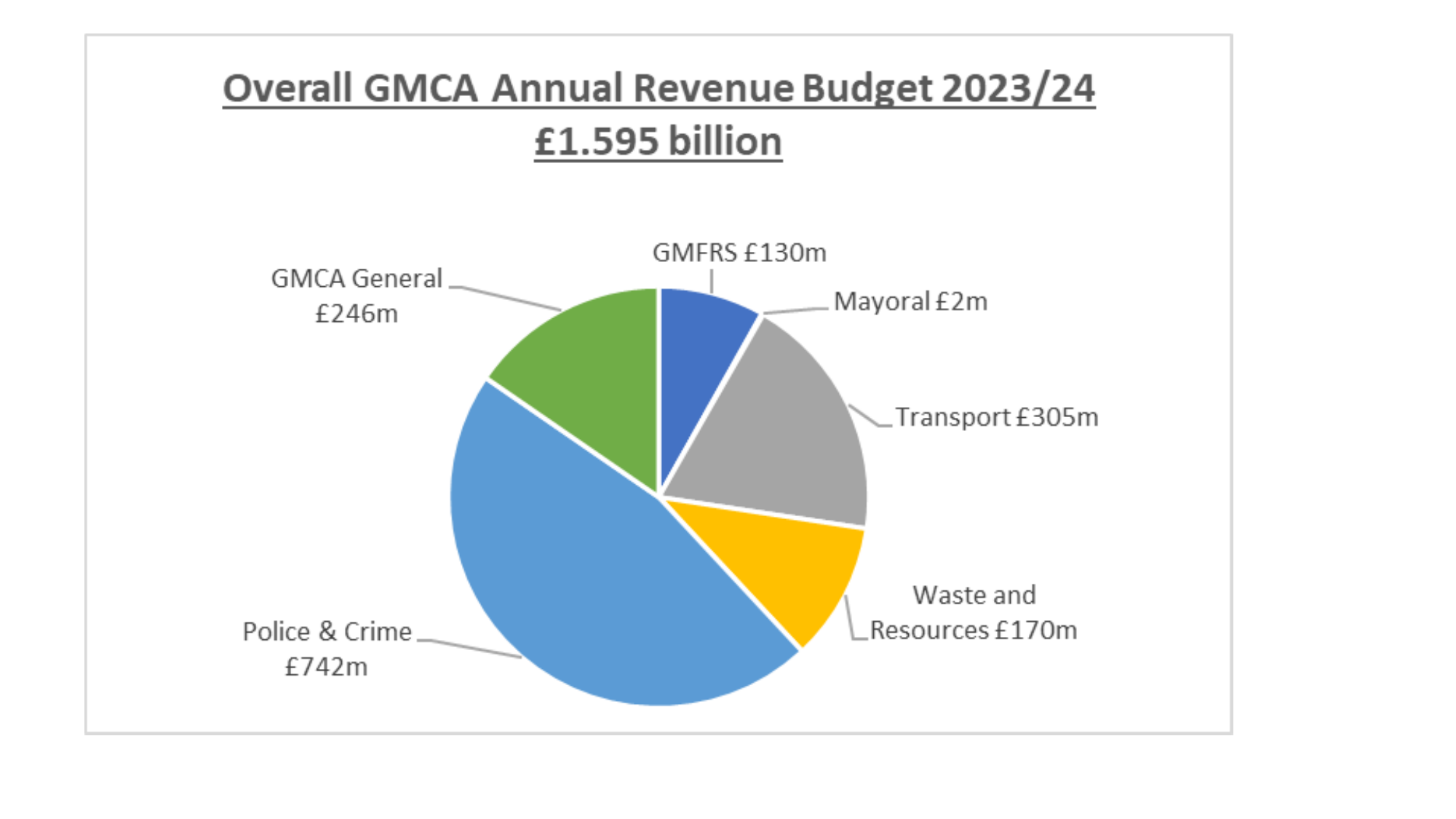
What is the difference between the Transport value and the Waste and Resources value? £135m What kind of chart is shown on the slide? Pie chart What is the value for Transport? £305m What is the value for GMFRS? £130m What is the value for Police & Crime? £742m Which category has the largest slice of the pie? Police & Crime What is the title of the chart? Overall GMCA Annual Revenue Budget 2023/24 £1.595 billion What is the difference between the Police & Crime value and the GMCA General value? £496m How many categories are shown in the pie chart? 6 What is the value for Waste and Resources? £170m Which category has the smallest slice of the pie? Mayoral Which is larger, GMCA General or Transport? Transport